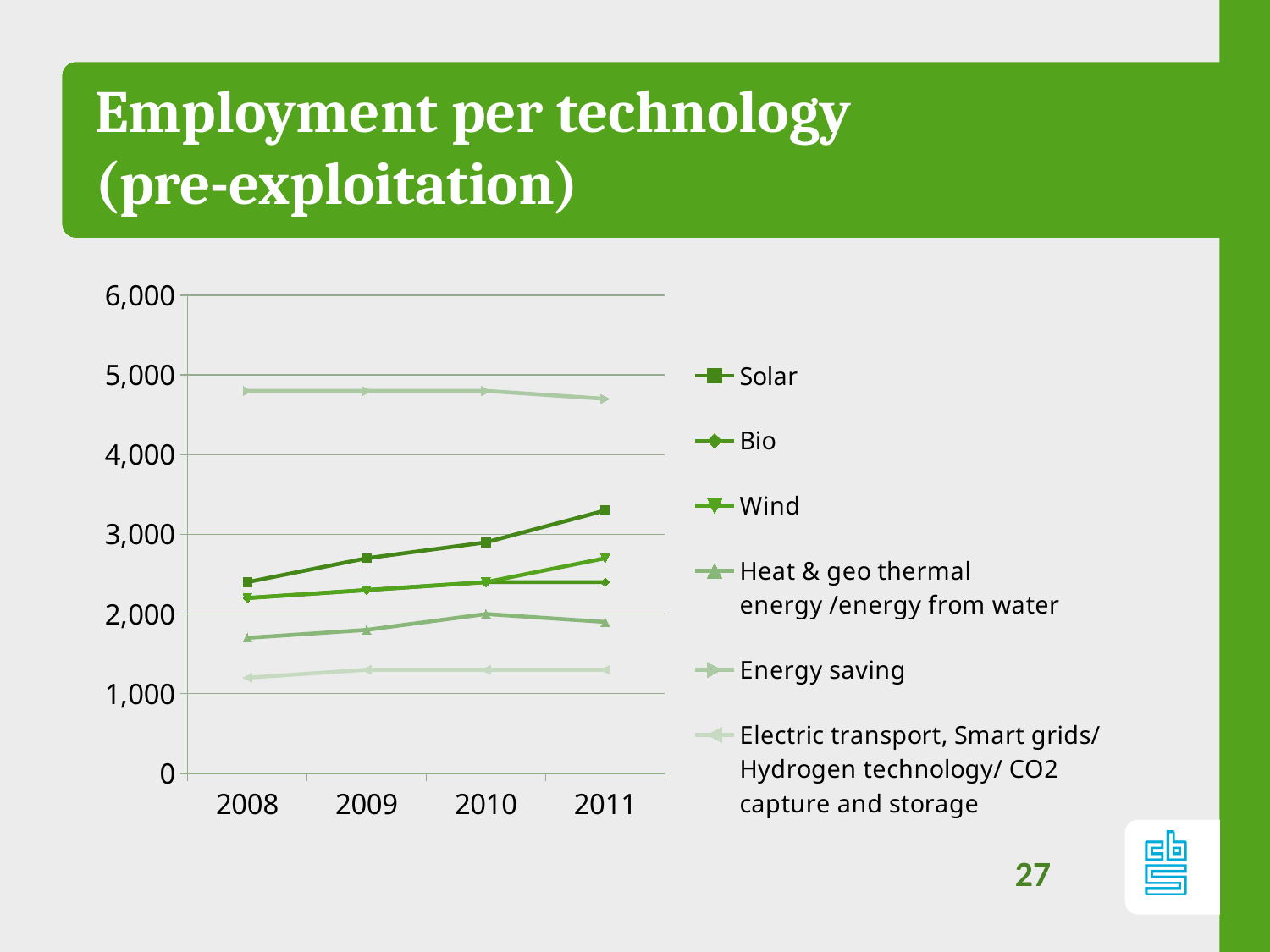
Which is larger in 2011, Solar or Heat & geo thermal energy /energy from water? Solar Does the Solar series rise or fall from 2008 to 2011? rise How many years are shown on the x axis? 4 What kind of chart is shown on the slide? line chart Which series has the highest employment in 2011? Energy saving Which series has the lowest employment in 2008? Electric transport, Smart grids/ Hydrogen technology/ CO2 capture and storage Is the value for Energy saving in 2008 greater or less than 4,000? greater Which is larger in 2011, Solar or Energy saving? Energy saving What is the title of the slide containing the chart? Employment per technology (pre-exploitation) Is the value for Heat & geo thermal energy /energy from water in 2008 greater or less than 2,000? less How many series does the legend list? 6 Is the value for Solar in 2011 greater or less than 3,000? greater